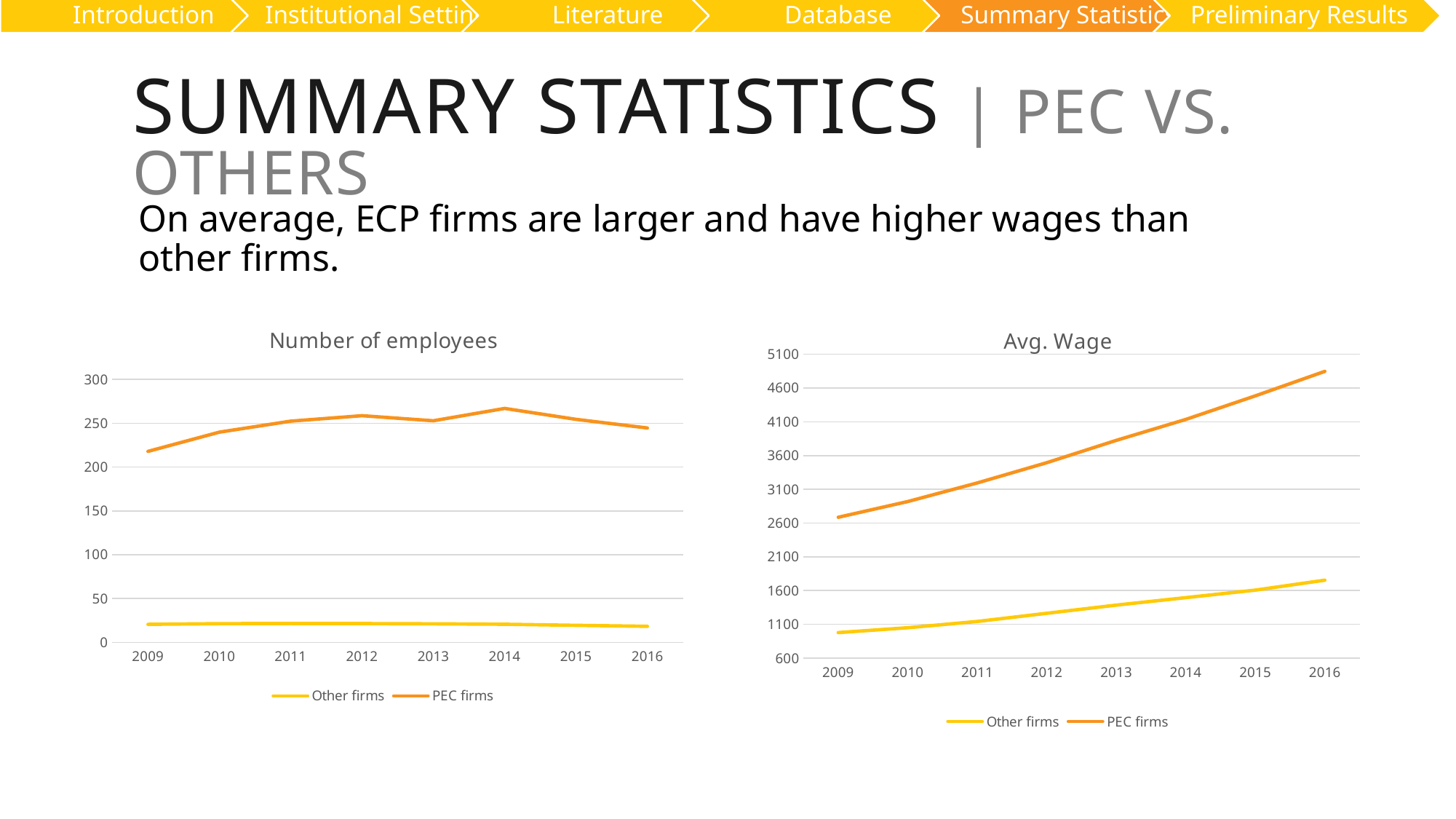
In the "Avg. Wage" chart, in which year is the PEC firms value highest? 2016 In the "Number of employees" chart, in which year is the PEC firms value highest? 2014 In the "Avg. Wage" chart, in which year is the Other firms value lowest? 2009 What kind of chart is the "Number of employees" chart? line chart How many years are shown on the x axis of the "Number of employees" chart? 8 How many series does the legend of the "Avg. Wage" chart list? 2 In the "Number of employees" chart, is the PEC firms value for 2014 greater or less than 250? greater In the "Avg. Wage" chart, is the Other firms value for 2009 greater or less than 1100? less In the "Avg. Wage" chart, does the PEC firms line rise or fall from 2009 to 2016? rise In the "Number of employees" chart, which series is higher in 2012, Other firms or PEC firms? PEC firms In the "Number of employees" chart, in which year is the PEC firms value lowest? 2009 In the "Avg. Wage" chart, is the PEC firms value for 2016 greater or less than 4600? greater